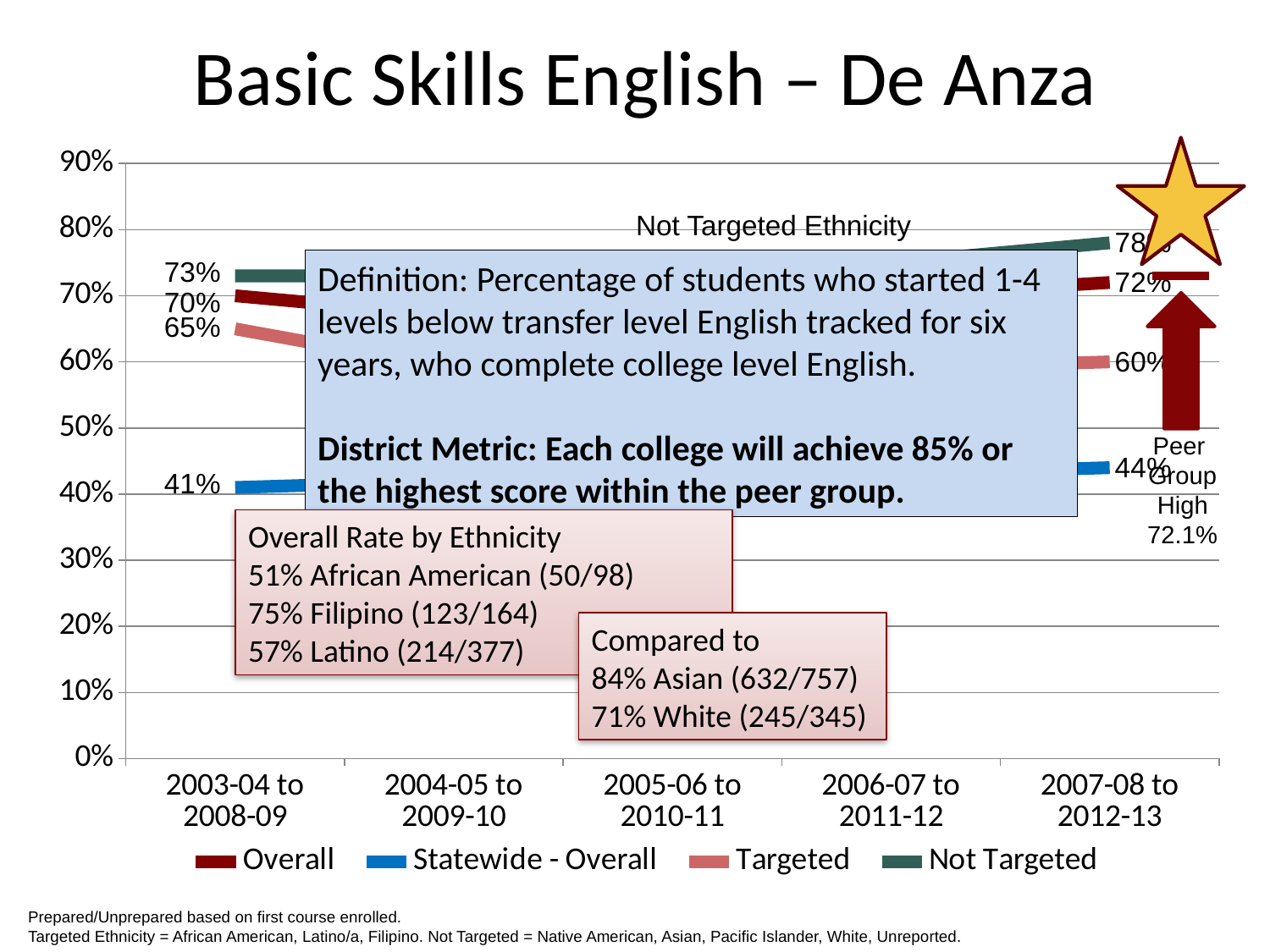
By how many percentage points did the Overall value change from the 2003-04 to 2008-09 cohort to the 2007-08 to 2012-13 cohort? 2 percentage points Is the Not Targeted value for the 2007-08 to 2012-13 cohort greater or less than 70%? greater Which series has the lowest value in the 2003-04 to 2008-09 cohort? Statewide - Overall What is the Targeted value for the 2007-08 to 2012-13 cohort? 60% How many cohort periods are shown on the x axis? 5 What kind of chart is shown on the slide? Line chart What is the Overall value for the 2003-04 to 2008-09 cohort? 70% What is the Statewide - Overall value for the 2003-04 to 2008-09 cohort? 41% What is the Not Targeted value for the 2003-04 to 2008-09 cohort? 73% How many series does the legend list? 4 In the 2007-08 to 2012-13 cohort, which is larger: the Overall value or the Targeted value? Overall What is the difference between the Targeted value in 2003-04 to 2008-09 and in 2007-08 to 2012-13? 5 percentage points